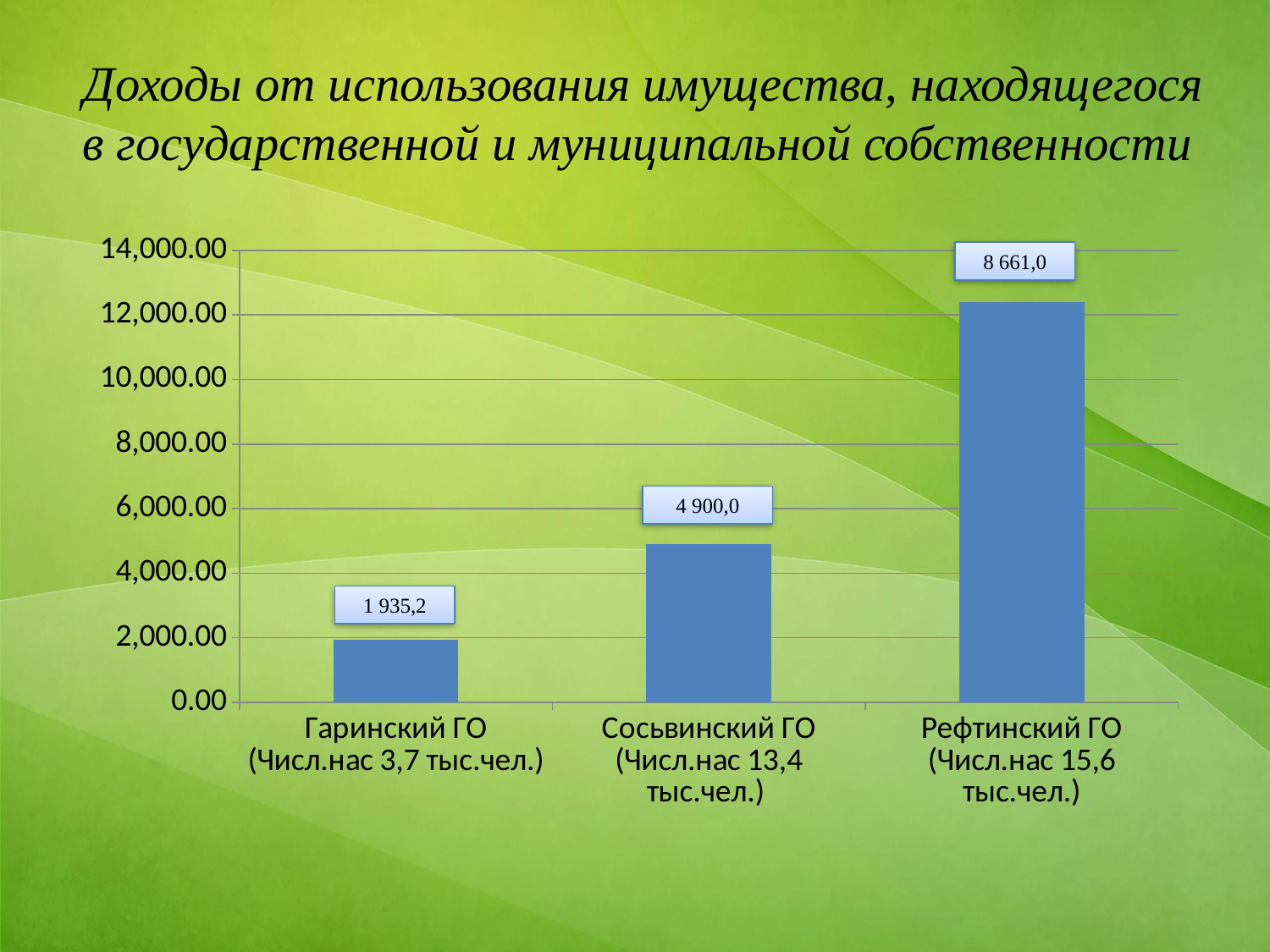
What is the value shown for Гаринский ГО? 1 935,2 Is the value for Гаринский ГО greater or less than 2,000.00? less Which category has the lowest bar? Гаринский ГО What kind of chart is shown on the slide? Bar chart Which is larger, the value for Сосьвинский ГО or the value for Гаринский ГО? Сосьвинский ГО What is the value shown for Рефтинский ГО? 8 661,0 Is the value for Рефтинский ГО greater or less than 8,000.00? greater Do the bar values rise or fall from left to right along the x axis? Rise Which category has the highest bar? Рефтинский ГО What is the difference between the labelled values for Сосьвинский ГО and Гаринский ГО? 2 964,8 What is the value shown for Сосьвинский ГО? 4 900,0 How many categories are shown on the x axis? 3